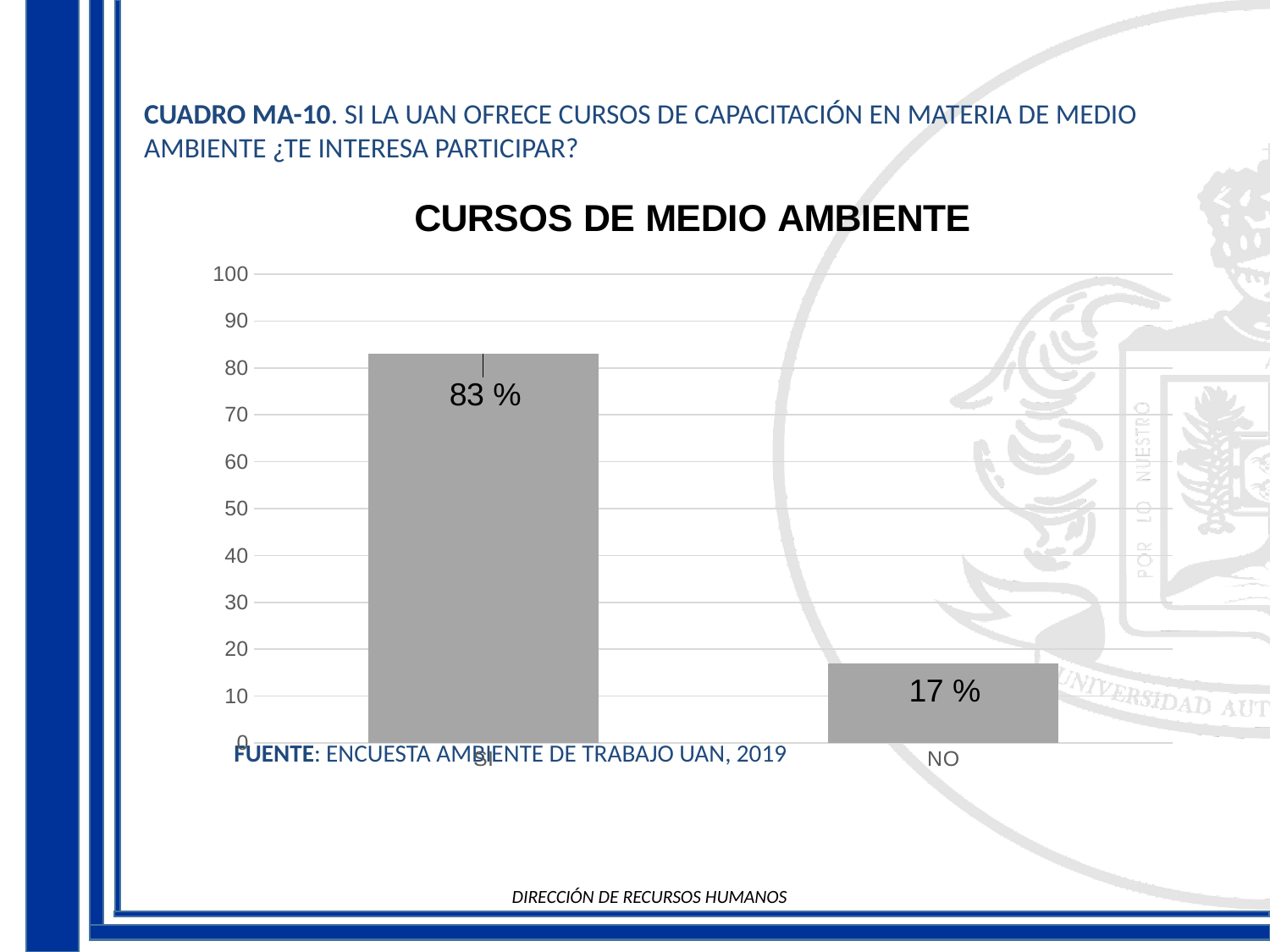
Which is larger, the value for SI or the value for NO? SI What is the value for NO in the CURSOS DE MEDIO AMBIENTE chart? 17 % What is the title of the chart? CURSOS DE MEDIO AMBIENTE What is the highest value shown on the vertical axis of the chart? 100 What kind of chart is shown on the slide? bar chart Is the value for NO greater or less than 20? less What is the value for SI in the CURSOS DE MEDIO AMBIENTE chart? 83 % Which category has the lowest value in the chart? NO Which category has the highest value in the chart? SI What is the difference between the values for SI and NO? 66 % How many categories are shown in the chart? 2 Is the value for SI greater or less than 80? greater